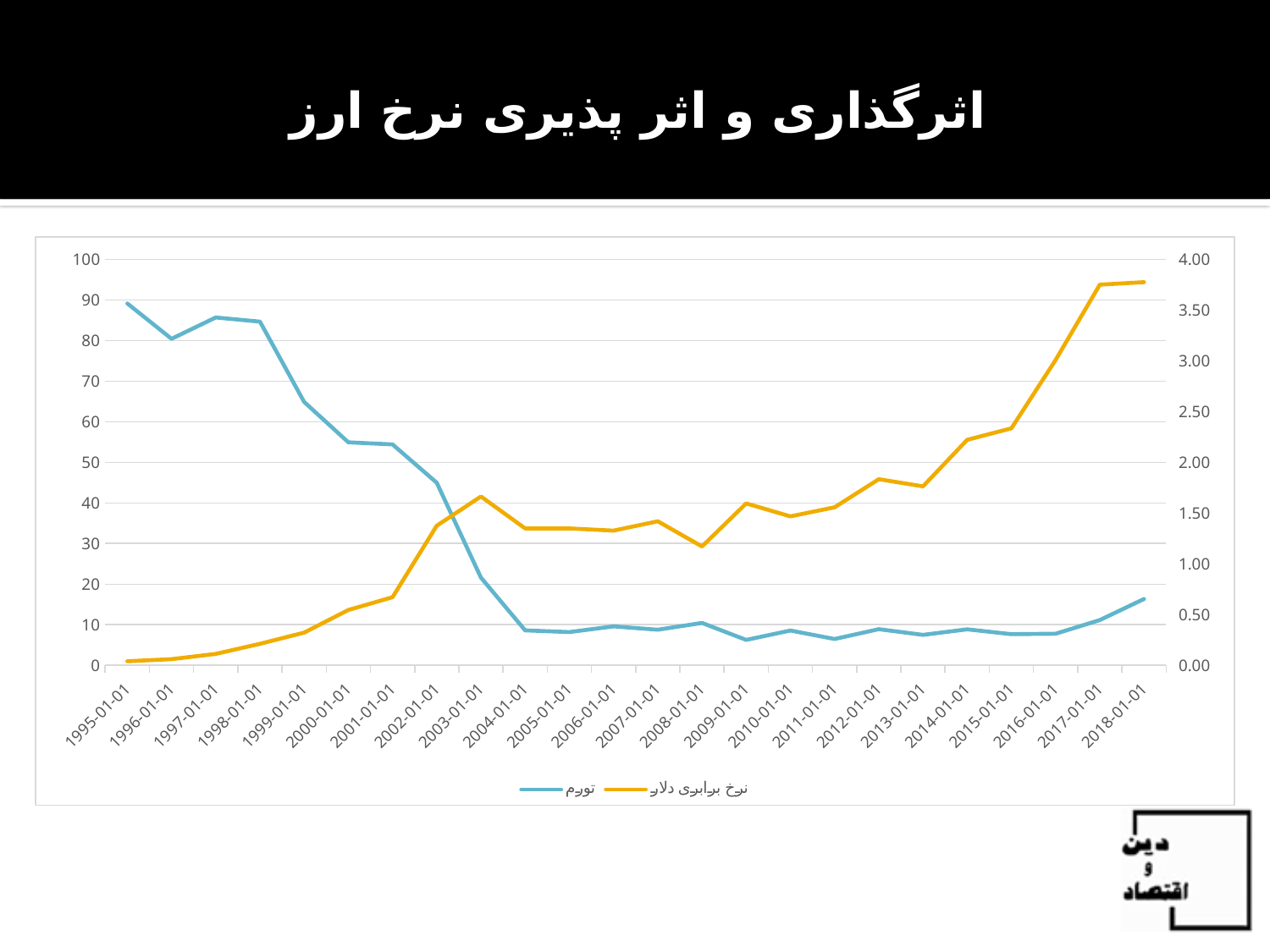
Is the value of نرخ برابری دلار at 2008-01-01 greater or less than 1.50? less At which date is the تورم series highest? 1995-01-01 How many dates are shown along the x axis? 24 Is the value of تورم at 2000-01-01 greater or less than 60? less Is the value of نرخ برابری دلار at 2017-01-01 greater or less than 3.50? greater What kind of chart is shown on the slide? line chart How many series does the legend list? 2 Does the تورم (blue) series rise or fall from 1995-01-01 to 2004-01-01? fall Does the نرخ برابری دلار (orange) series rise or fall from 2013-01-01 to 2017-01-01? rise At which date is the نرخ برابری دلار series lowest? 1995-01-01 Which is larger for the تورم series: the value at 1995-01-01 or at 2018-01-01? 1995-01-01 Which axis scale, left or right, runs from 0.00 to 4.00? right